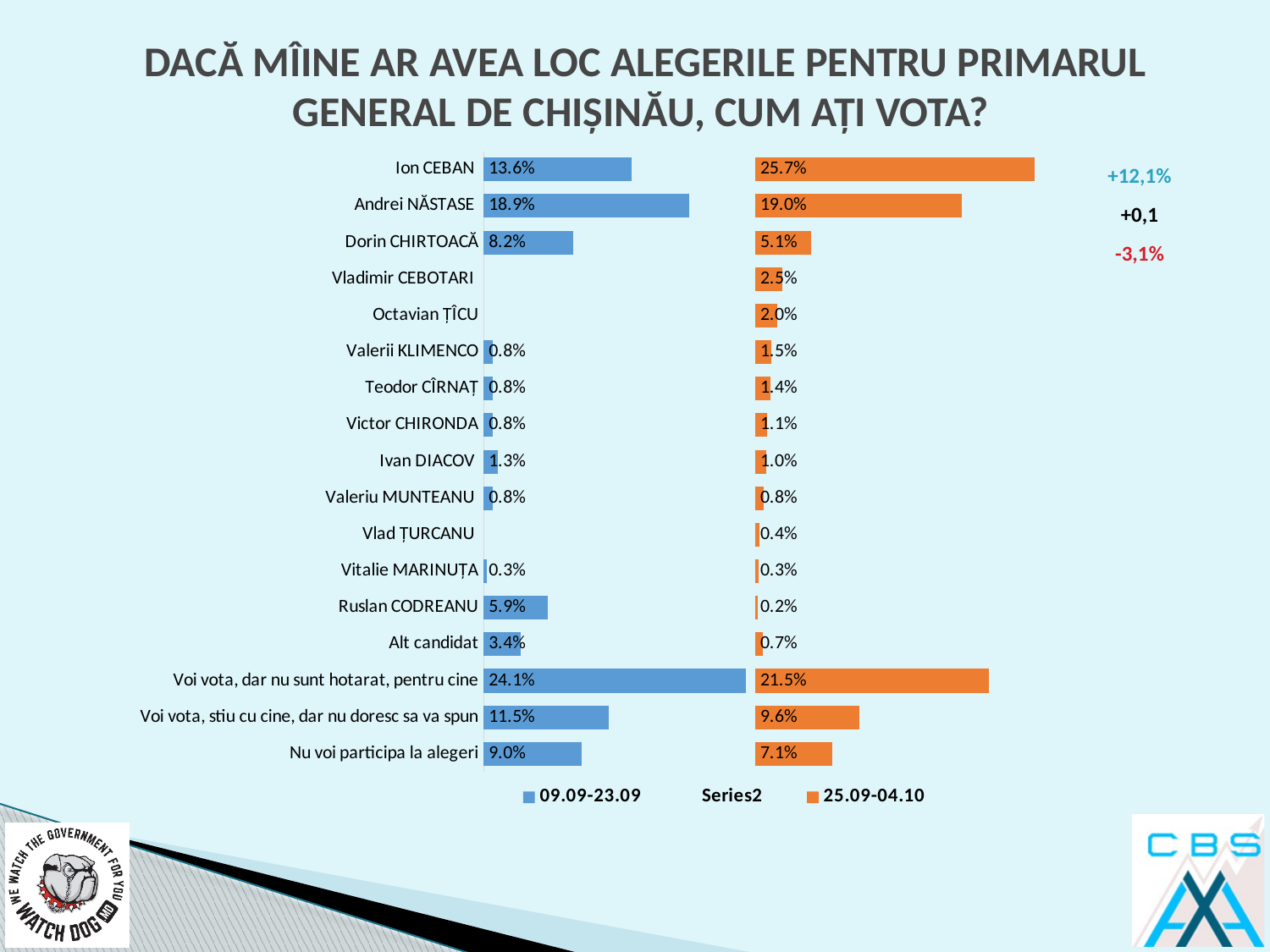
Which category has the lowest value in the 25.09-04.10 series? Ruslan CODREANU What kind of chart is shown on the slide? bar chart Which is larger for Andrei NĂSTASE: the 09.09-23.09 value or the 25.09-04.10 value? 25.09-04.10 Which category has the highest value in the 25.09-04.10 series? Ion CEBAN What is the difference between Dorin CHIRTOACĂ's 09.09-23.09 value and his 25.09-04.10 value? 3.1% How many categories are shown on the chart? 17 How many entries does the legend list? 3 Which category has the highest value in the 09.09-23.09 series? Voi vota, dar nu sunt hotarat, pentru cine What is the difference between Ion CEBAN's 25.09-04.10 value and his 09.09-23.09 value? 12.1% What is the value for Ion CEBAN in the 25.09-04.10 series? 25.7% What is the value for Ruslan CODREANU in the 09.09-23.09 series? 5.9% What is the value for 'Nu voi participa la alegeri' in the 25.09-04.10 series? 7.1%